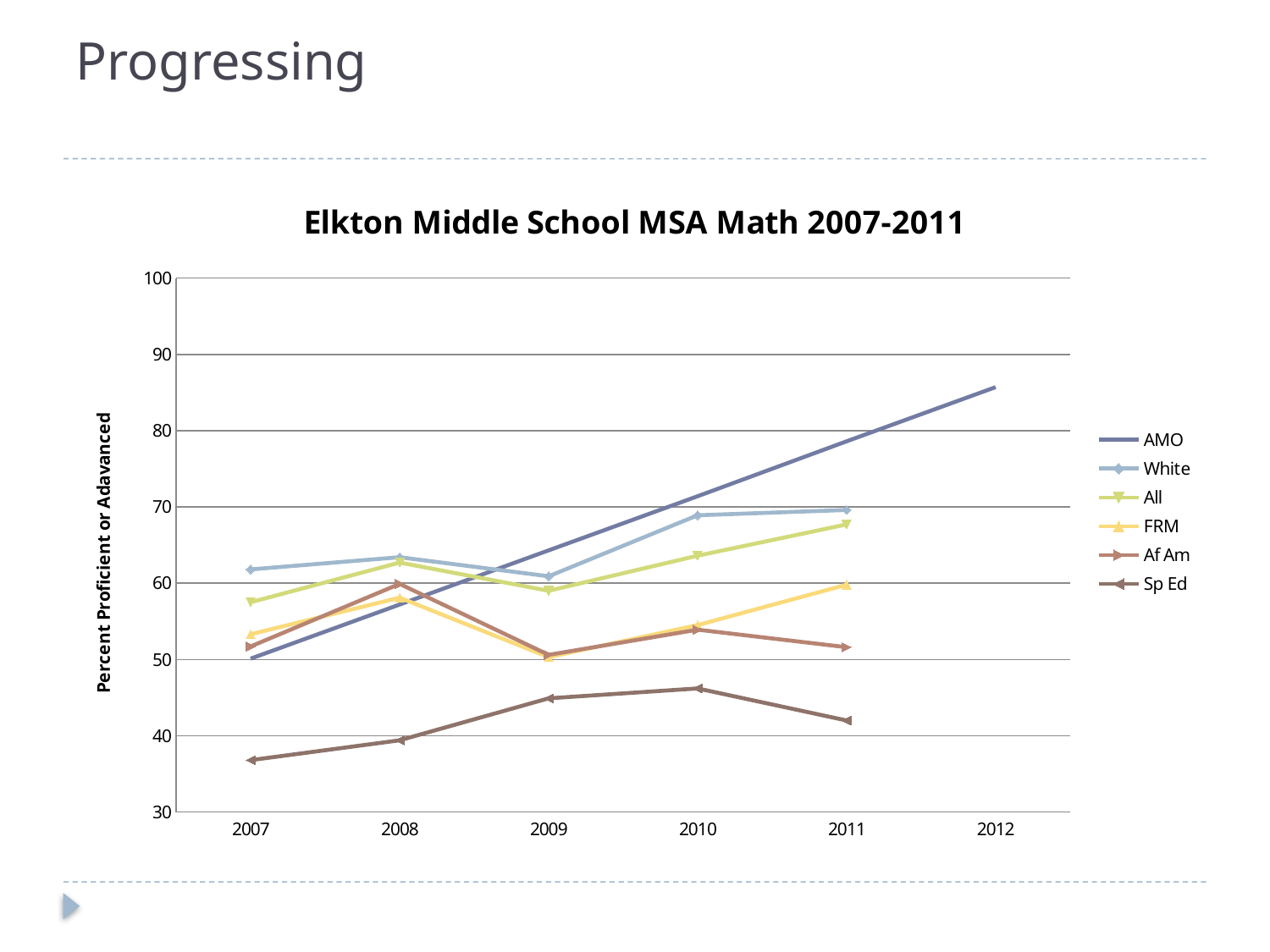
Which series has the lowest value in 2011? Sp Ed What is the label on the vertical axis? Percent Proficient or Adavanced How many years are shown on the x axis? 6 Is the value for Sp Ed in 2007 greater or less than 40? less How many series does the legend list? 6 Is the value for AMO in 2012 greater or less than 80? greater Which series has the highest value in 2011? AMO What is the title of the chart? Elkton Middle School MSA Math 2007-2011 Does the AMO line rise or fall from 2007 to 2012? rise What kind of chart is shown on the slide? line chart In 2011, which is larger, the value for White or the value for All? White Is the value for White in 2007 greater or less than 60? greater